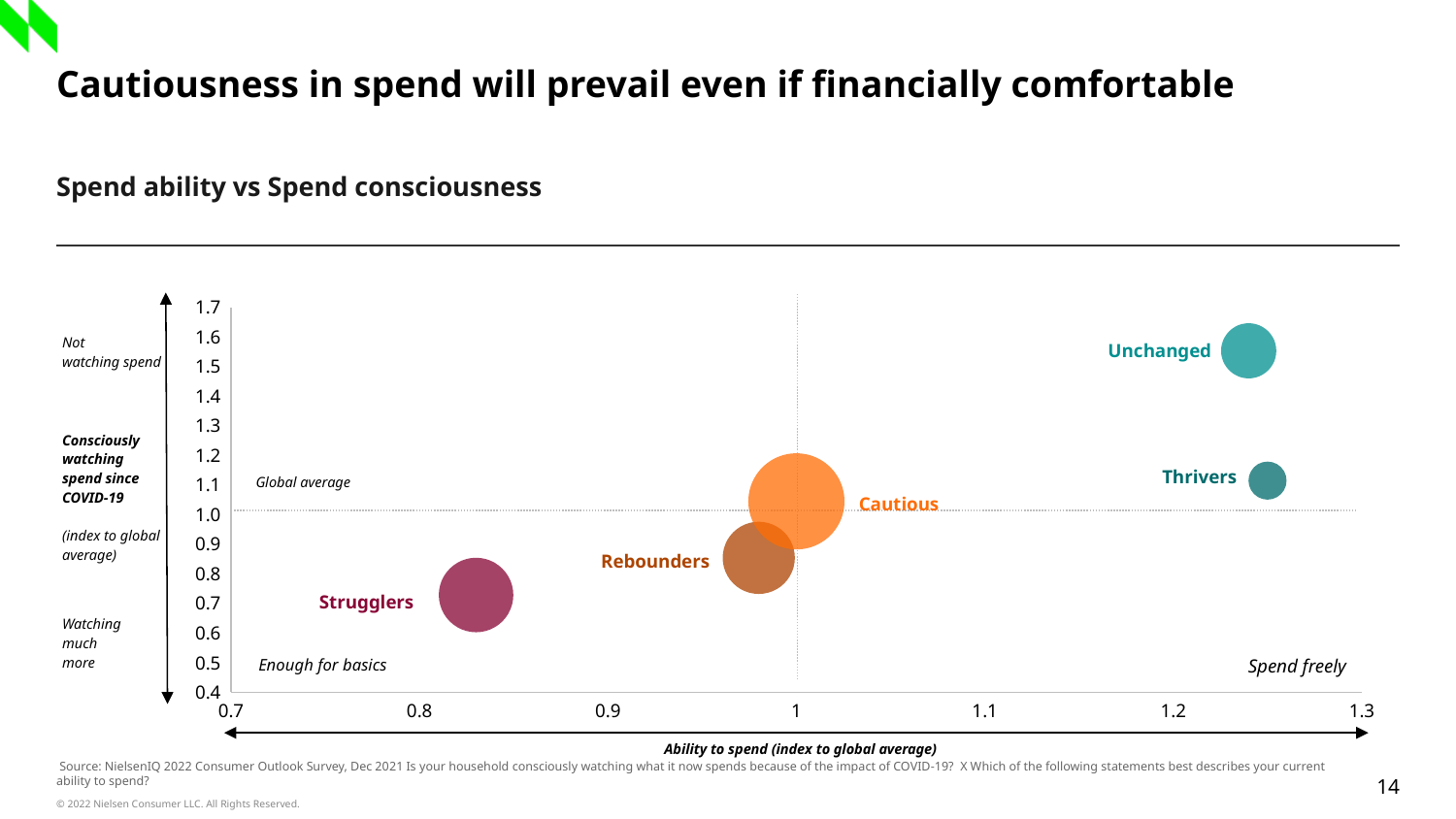
Which group is furthest left on the horizontal axis (lowest ability to spend)? Strugglers Is the vertical-axis value for Unchanged greater or less than 1.4? greater What is the label of the horizontal axis? Ability to spend (index to global average) What kind of chart is shown on the slide? Bubble chart Is the horizontal-axis value for Strugglers greater or less than 0.9? less Which group is higher on the vertical axis, Unchanged or Thrivers? Unchanged Which group has the highest value on the vertical axis (spend consciousness index)? Unchanged Is the vertical-axis value for Rebounders greater or less than 1.0? less Which group is further right on the horizontal axis, Strugglers or Rebounders? Rebounders Which group has the lowest value on the vertical axis? Strugglers How many labelled bubbles (consumer groups) are plotted on the chart? 5